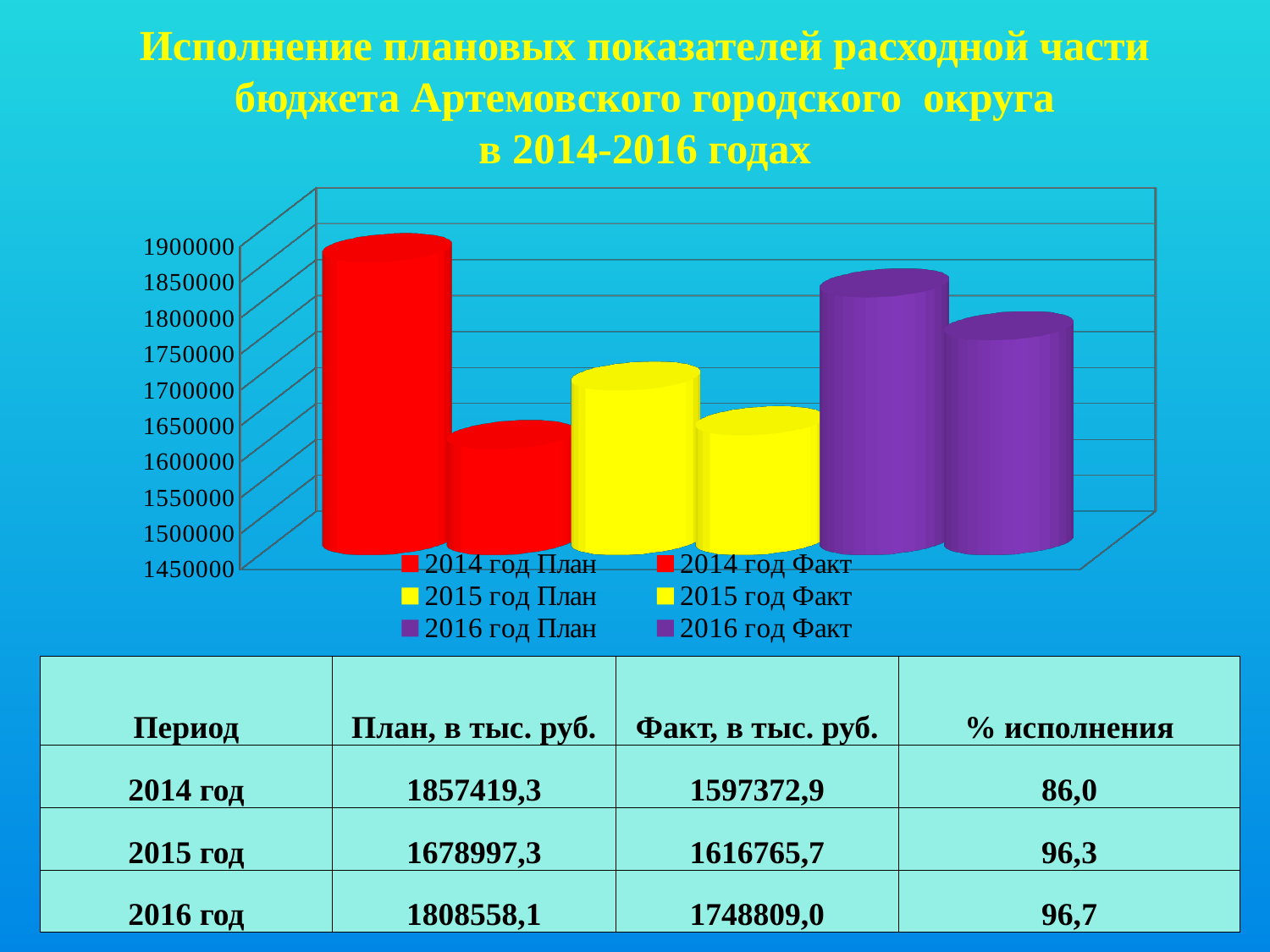
Using the table values, what is the difference between План and Факт for 2014 год (in тыс. руб.)? 260046,4 Which series has the lowest bar in the chart? 2014 год Факт Which series has the highest bar in the chart? 2014 год План How many series does the chart legend list? 6 Is the value for 2014 год Факт greater or less than 1650000? less Which is larger, the bar for 2016 год План or the bar for 2015 год План? 2016 год План According to the table on the slide, what is the % исполнения for 2016 год? 96,7 How many bars are plotted in the chart? 6 Is the value for 2014 год План greater or less than 1800000? greater What kind of chart is shown on the slide? bar chart According to the table on the slide, what is the План value (in тыс. руб.) for 2015 год? 1678997,3 Is the value for 2016 год Факт greater or less than 1800000? less